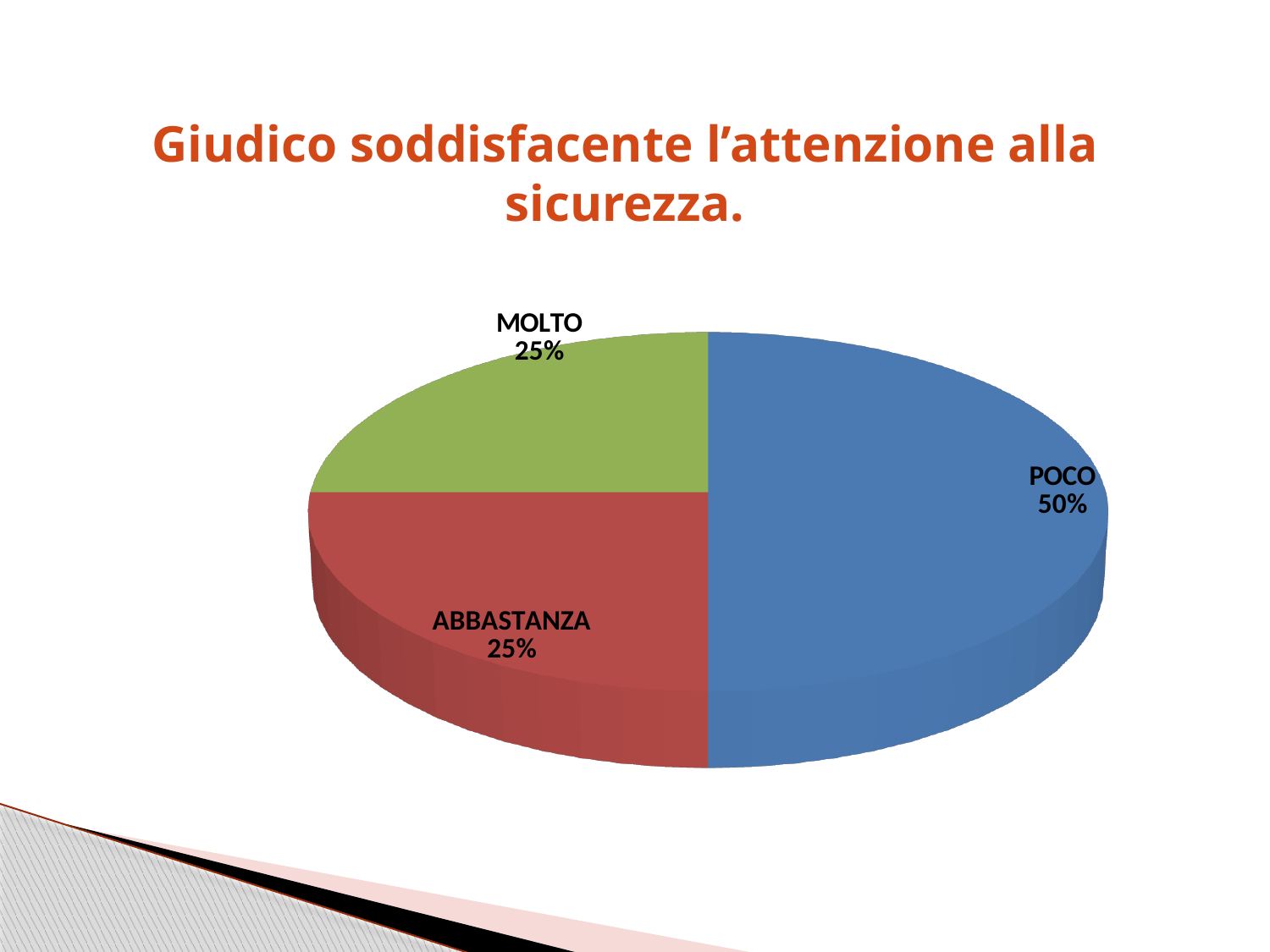
What kind of chart is shown on the slide? pie chart How many slices does the pie chart have? 3 What share of the pie does the POCO slice represent? 50% What colour is the POCO slice of the pie chart? blue What share of the pie does the ABBASTANZA slice represent? 25% What is the difference between the POCO share and the MOLTO share? 25% What is the title of the slide containing the pie chart? Giudico soddisfacente l'attenzione alla sicurezza. What is the combined share of the MOLTO and ABBASTANZA slices? 50% What share of the pie does the MOLTO slice represent? 25% Which category has the largest slice of the pie? POCO Which is larger, the POCO slice or the ABBASTANZA slice? POCO